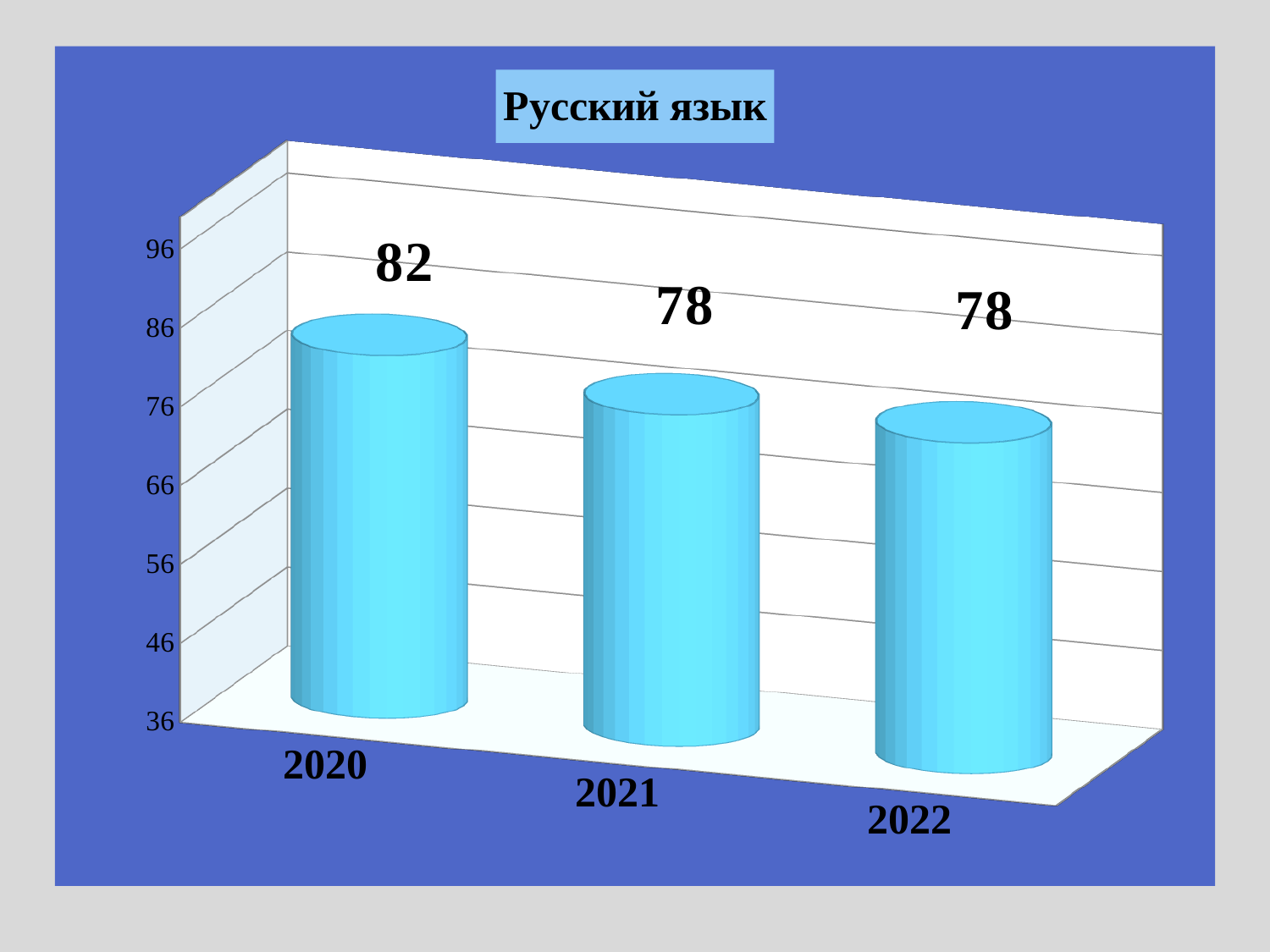
Is the value for 2021 greater or less than 86? less Which is larger, the value for 2020 or the value for 2022? 2020 What is the difference between the values for 2020 and 2021? 4 How many years are shown on the chart? 3 Is the value for 2020 greater or less than 76? greater Do the values rise or fall from 2020 to 2021? fall What is the value for 2022? 78 What is the value for 2020? 82 What kind of chart is shown on the slide? bar chart Which year has the highest value? 2020 What is the value for 2021? 78 What is the title of the chart? Русский язык